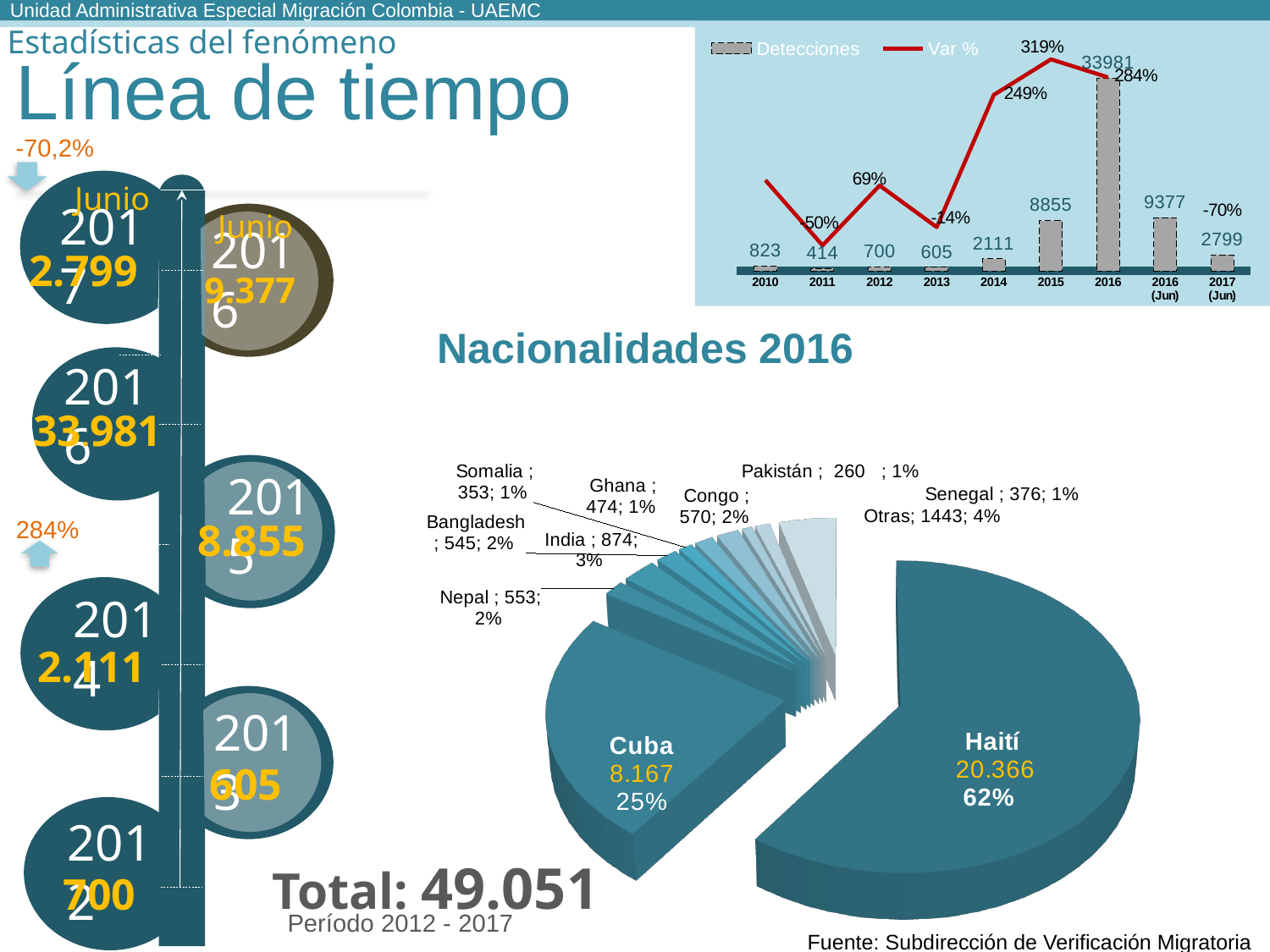
In the top-right chart, which year has the highest Detecciones value? 2016 In the top-right chart, what is the Var % value for 2017 (Jun)? -70% In the top-right chart, how many series does the legend list? 2 In the Nacionalidades 2016 pie chart, what share of the pie does Haití have? 62% In the Nacionalidades 2016 pie chart, which nationality has the smallest slice? Pakistán In the Nacionalidades 2016 pie chart, which is larger, the value for India or the value for Congo? India In the Nacionalidades 2016 pie chart, what value is shown for Cuba? 8.167 What type of chart is the Nacionalidades 2016 chart? Pie chart In the top-right chart, what is the Var % value for 2015? 319% In the top-right chart, what is the Detecciones value for 2016? 33981 In the top-right chart, what is the difference between the Detecciones values for 2015 and 2014? 6744 In the top-right chart, which year has the lowest Detecciones value? 2011